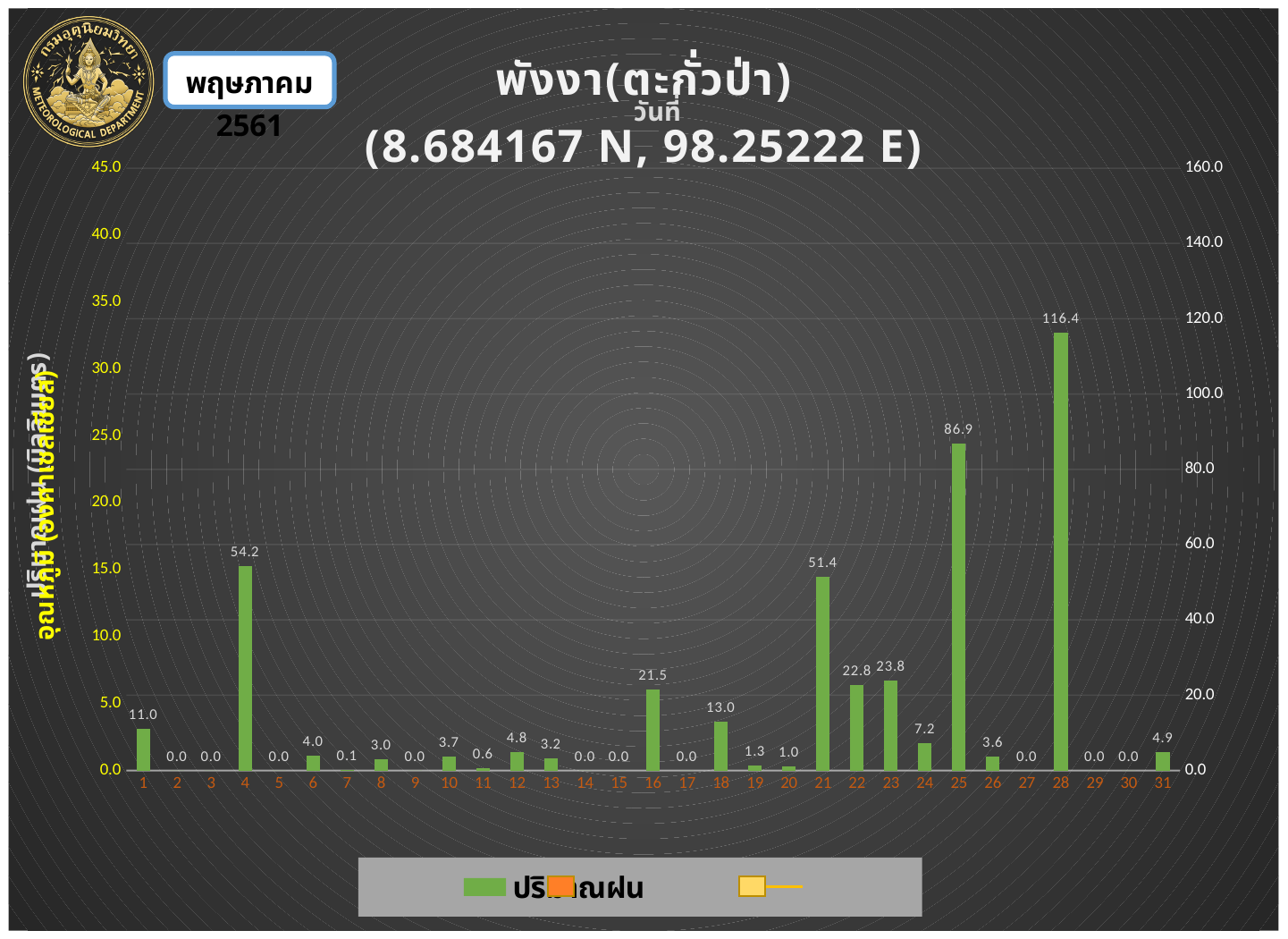
What is the difference between the rainfall values for day 23 and day 22? 1.0 How many days (categories) are shown on the x axis? 31 Which has a larger rainfall value, day 21 or day 4? day 4 What colour are the rainfall bars in the chart? green Which has a larger rainfall value, day 18 or day 1? day 18 What is the rainfall value shown for day 28? 116.4 What is the rainfall value shown for day 25? 86.9 What is the difference between the rainfall values for day 28 and day 25? 29.5 What is the rainfall value shown for day 4? 54.2 What kind of chart is shown on the slide? bar chart What is the rainfall value shown for day 16? 21.5 Which day has the highest rainfall value? 28